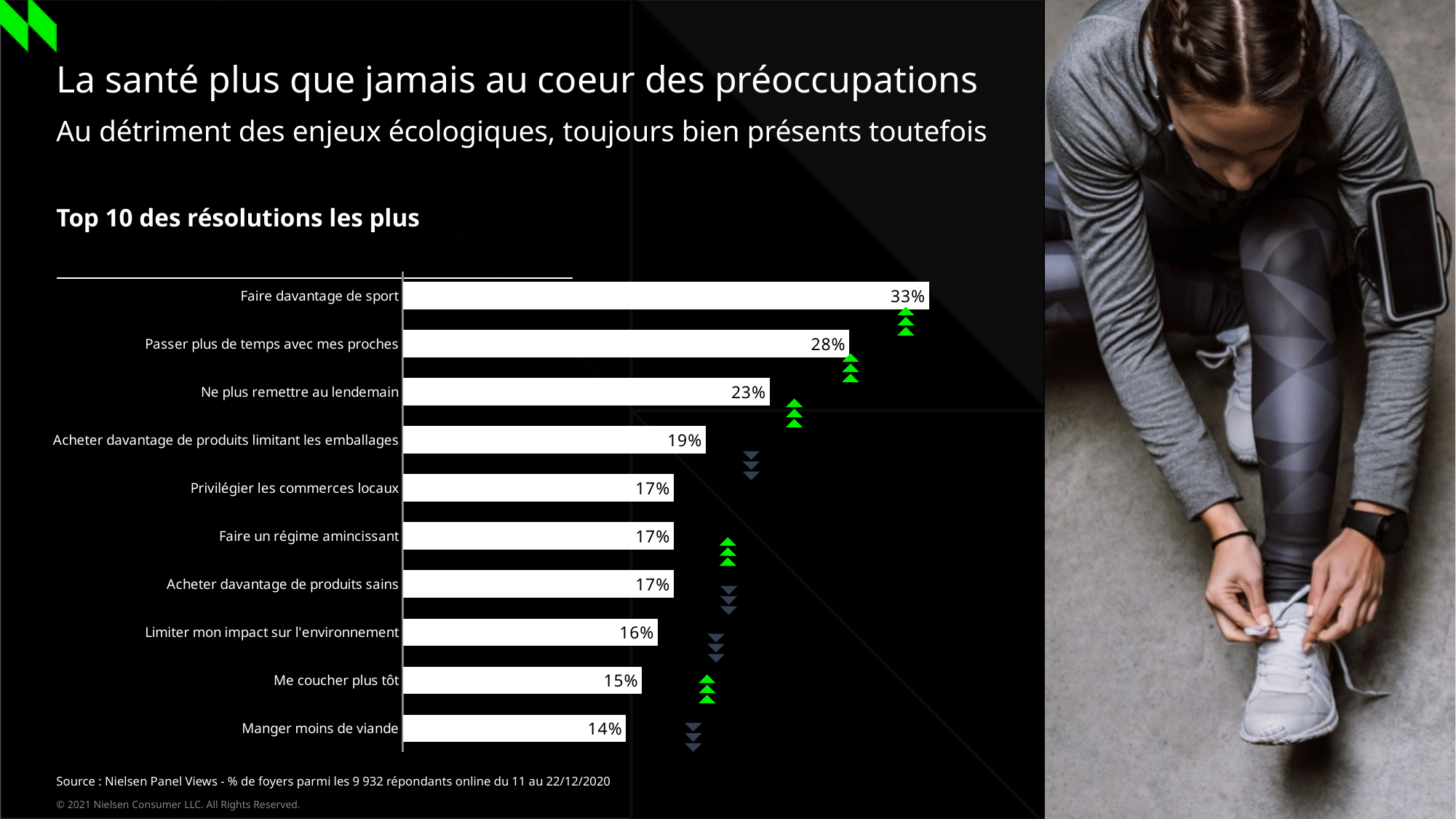
What kind of chart is shown on the slide? Bar chart What is the value for "Limiter mon impact sur l'environnement"? 16% What is the difference between "Faire davantage de sport" and "Passer plus de temps avec mes proches"? 5% Which resolution has the lowest value? Manger moins de viande Which is larger: "Ne plus remettre au lendemain" or "Privilégier les commerces locaux"? Ne plus remettre au lendemain What is the title of the chart? Top 10 des résolutions les plus What is the value for "Faire davantage de sport"? 33% How many resolutions are shown in the chart? 10 What is the value for "Manger moins de viande"? 14% What is the difference between "Acheter davantage de produits limitant les emballages" and "Me coucher plus tôt"? 4% What is the value for "Ne plus remettre au lendemain"? 23% Which resolution has the highest value? Faire davantage de sport